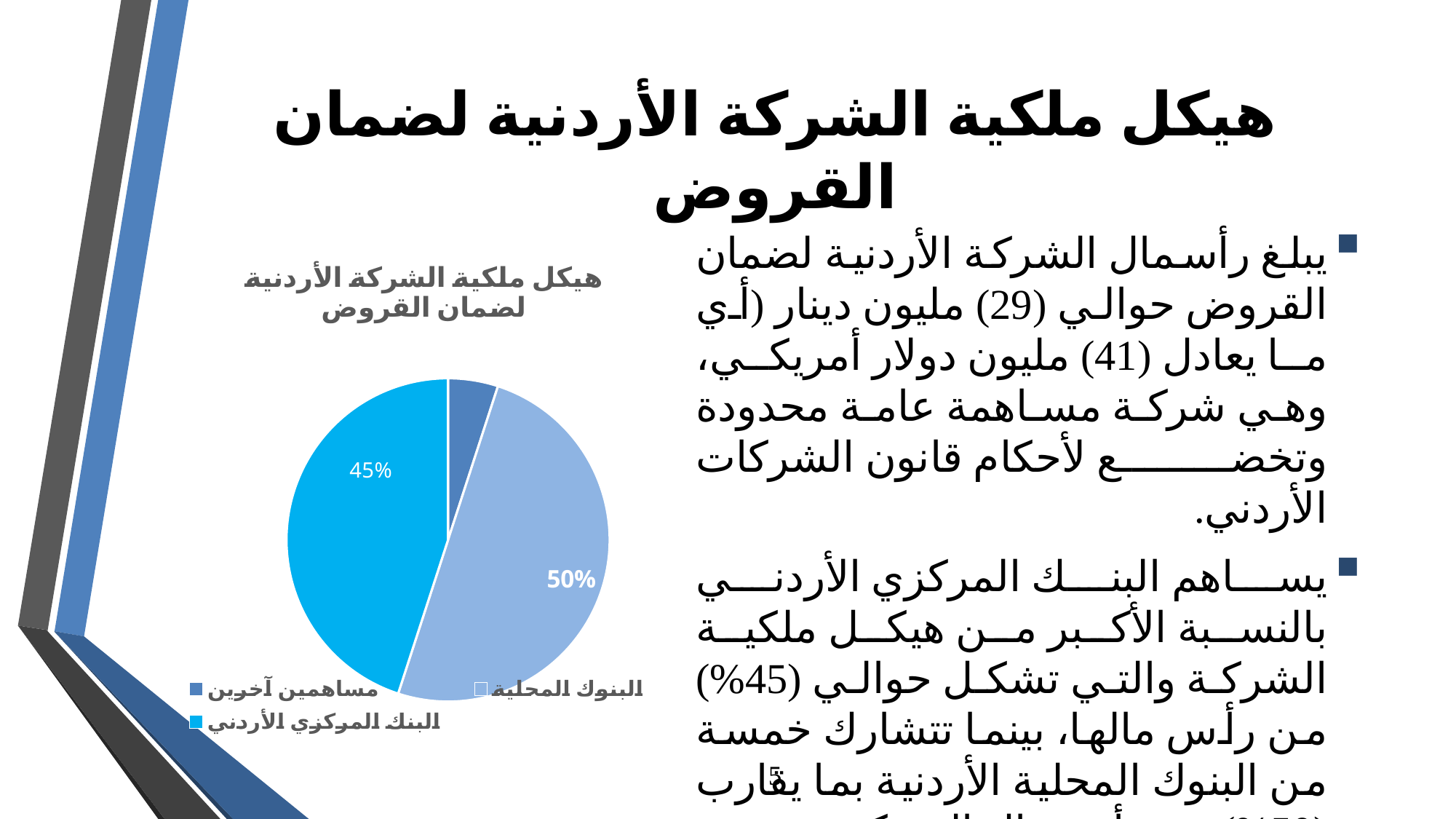
How many entries does the legend list? 3 Which category has the largest slice of the pie? البنوك المحلية What kind of chart is shown on the slide? Pie chart Which category has the smallest slice of the pie? مساهمين آخرين Which is larger, the slice for البنوك المحلية or the slice for البنك المركزي الأردني? البنوك المحلية What share of the pie is labelled for البنك المركزي الأردني? 45% Which legend entry is shown in the darkest blue colour? مساهمين آخرين What is the title of the chart? هيكل ملكية الشركة الأردنية لضمان القروض What share of the pie is labelled for البنوك المحلية? 50% What is the difference in percentage points between the slice for البنوك المحلية and the slice for البنك المركزي الأردني? 5 percentage points How many slices does the pie chart have? 3